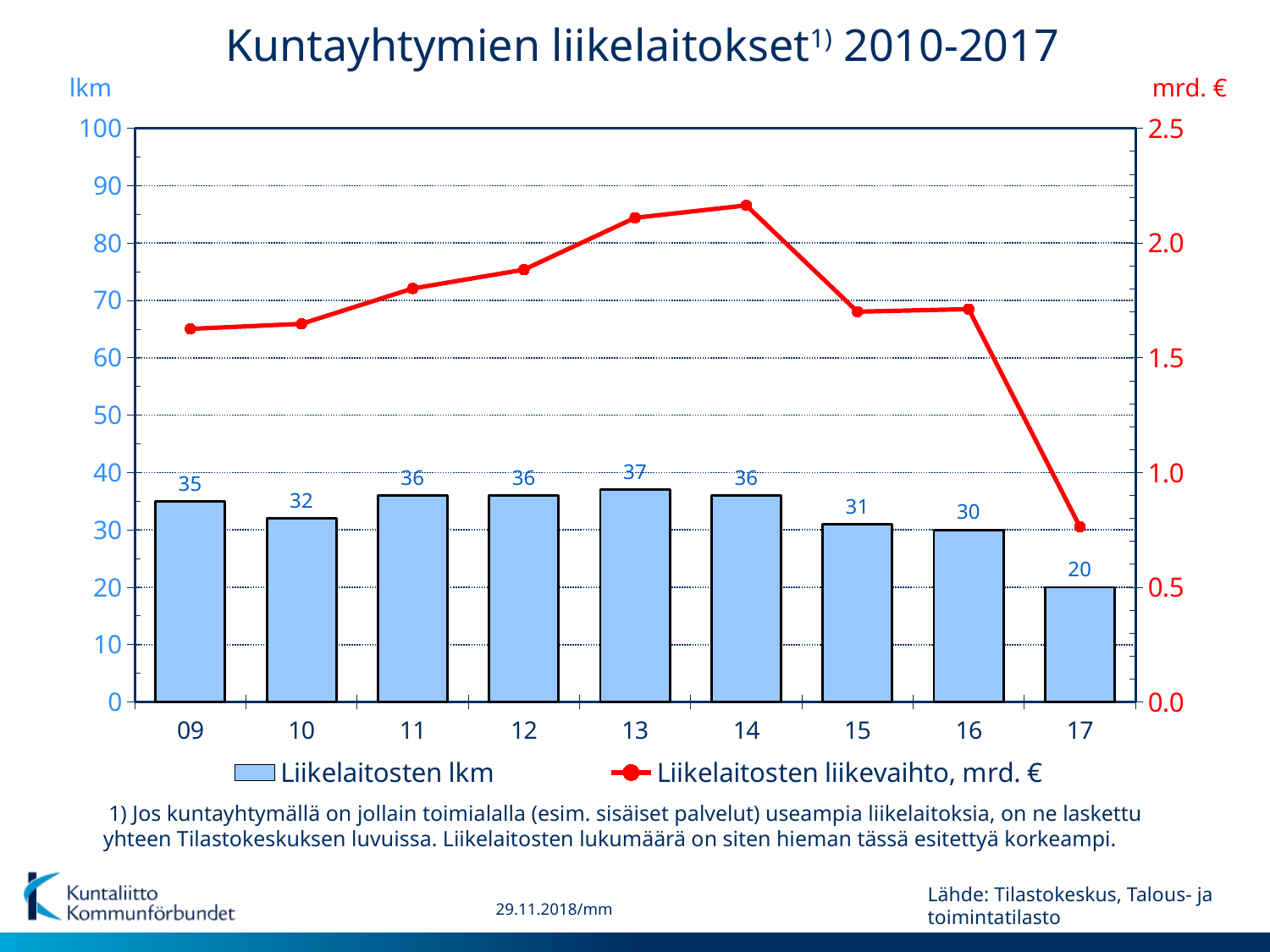
How many series does the legend list? 2 Which is larger, Liikelaitosten lkm in 09 or in 15? 09 What is the value of Liikelaitosten lkm for 10? 32 What is the difference between Liikelaitosten lkm in 16 and in 17? 10 What is the value of Liikelaitosten lkm for 17? 20 Is the value of Liikelaitosten liikevaihto, mrd. € for 17 greater or less than 1.0? less Which year has the highest value for Liikelaitosten lkm? 13 Is the value of Liikelaitosten liikevaihto, mrd. € for 14 greater or less than 2.0? greater What is the title of the chart? Kuntayhtymien liikelaitokset 2010-2017 Which year has the lowest value for Liikelaitosten lkm? 17 What is the value of Liikelaitosten lkm for 13? 37 How many years are shown on the x axis? 9